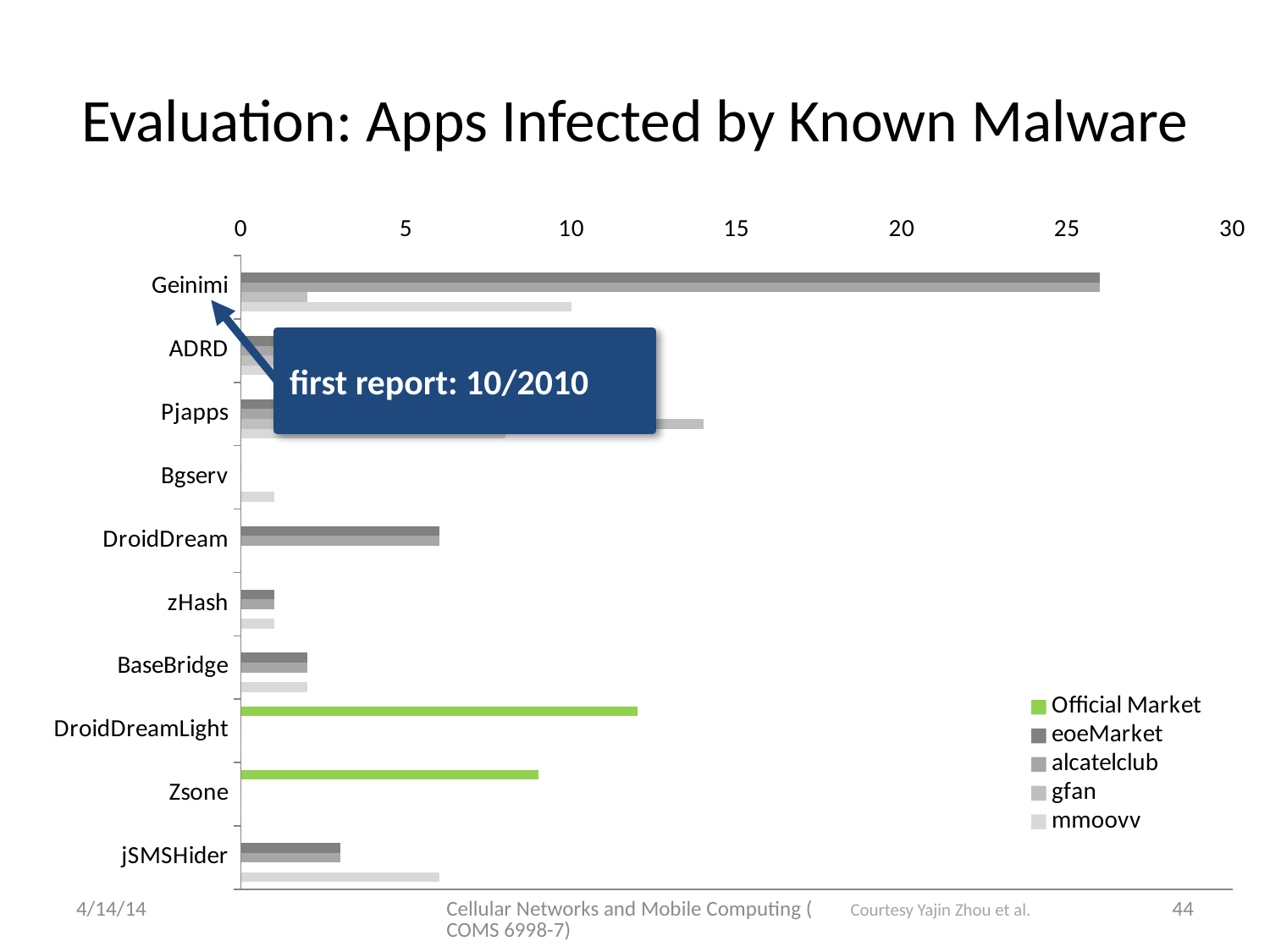
Which has the larger Official Market value, DroidDreamLight or Zsone? DroidDreamLight Is the gfan value for Pjapps greater or less than 10? greater Which has the larger gfan value, Pjapps or Geinimi? Pjapps How many malware families (categories) are listed on the vertical axis of the chart? 10 How many series does the chart's legend list? 5 What is the title of the slide containing the chart? Evaluation: Apps Infected by Known Malware Which malware family has the longest bar in the chart? Geinimi Is the mmoovv value for Bgserv greater or less than 5? less Is the Official Market value for Zsone greater or less than 5? greater What kind of chart is shown on the slide? bar chart